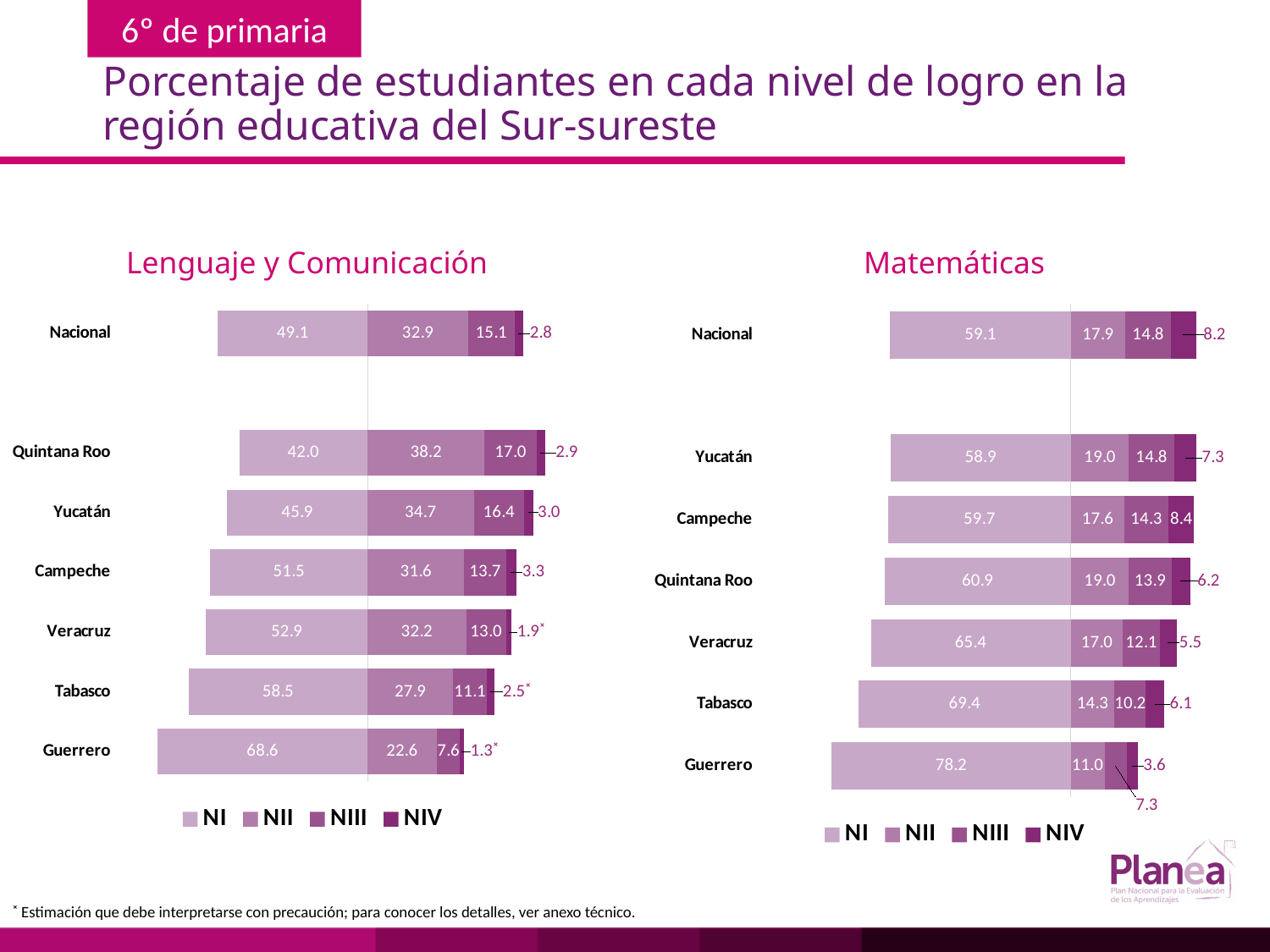
How many series does the legend of the Lenguaje y Comunicación chart list? 4 In the Matemáticas chart, what is the difference between the NI values of Guerrero and Nacional? 19.1 In the Lenguaje y Comunicación chart, what is the NI value for Guerrero? 68.6 In the Matemáticas chart, what is the NII value for Tabasco? 14.3 In the Lenguaje y Comunicación chart, which is larger: the NII value for Quintana Roo or the NII value for Yucatán? Quintana Roo In the Lenguaje y Comunicación chart, what is the NIV value for Campeche? 3.3 What are the legend entries of the Matemáticas chart? NI, NII, NIII, NIV What type of chart is the Matemáticas chart? Stacked bar chart In the Matemáticas chart, which state has the highest NI value? Guerrero In the Matemáticas chart, what is the NIV value for Campeche? 8.4 How many categories (bars) are shown in the Matemáticas chart? 7 In the Lenguaje y Comunicación chart, which category has the lowest NIII value? Guerrero